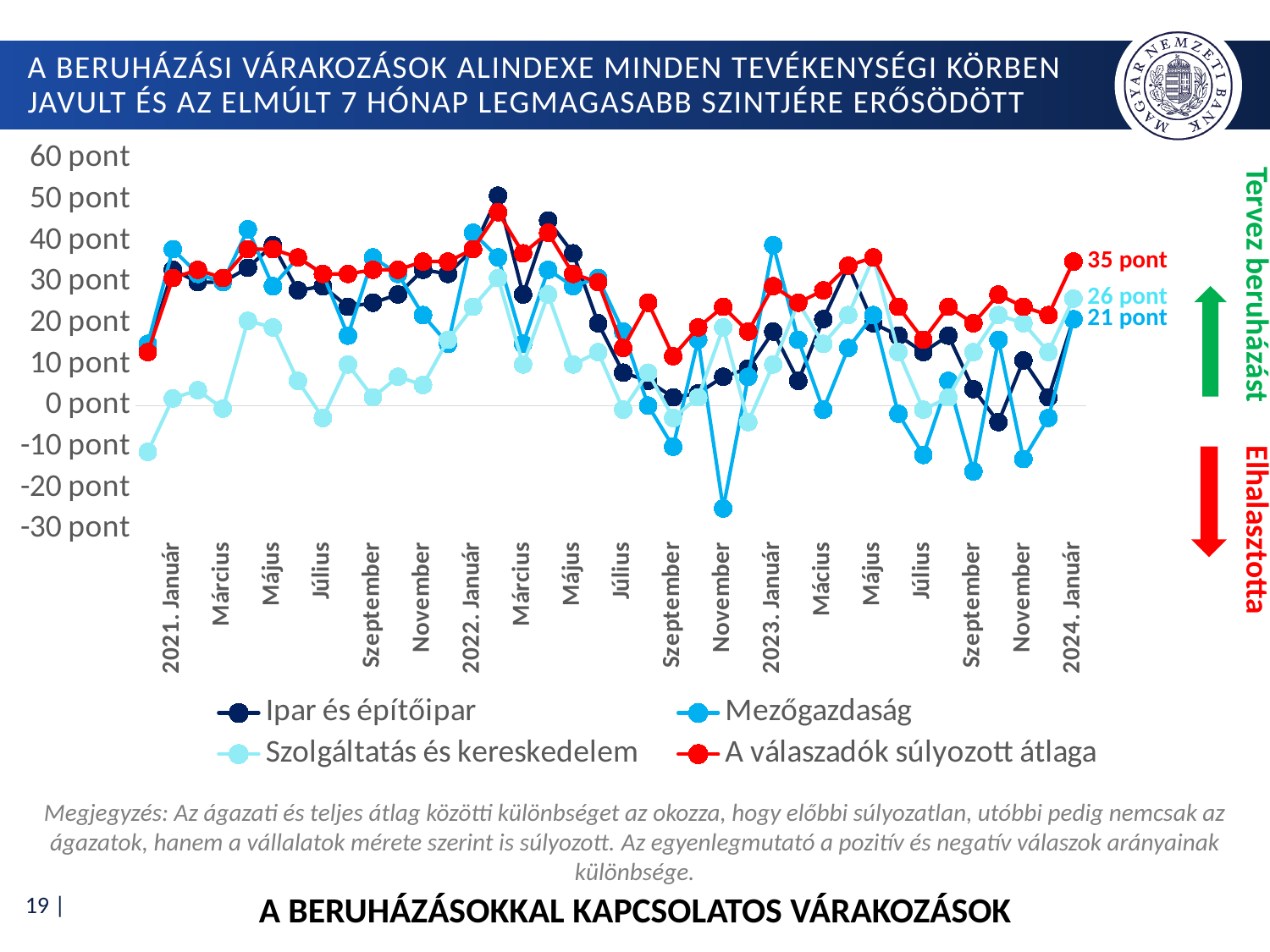
What is the difference between 'A válaszadók súlyozott átlaga' and 'Szolgáltatás és kereskedelem' in 2024. Január? 9 pont What is the title printed below the chart? A BERUHÁZÁSOKKAL KAPCSOLATOS VÁRAKOZÁSOK What is the value of 'Mezőgazdaság' in 2024. Január? 21 pont What is the value of 'A válaszadók súlyozott átlaga' in 2024. Január? 35 pont Is the value for 'Mezőgazdaság' in November 2022 greater or less than -20 pont? less In 2024. Január, which is larger: 'A válaszadók súlyozott átlaga' or 'Szolgáltatás és kereskedelem'? A válaszadók súlyozott átlaga What kind of chart is shown on the slide? line chart What is the difference between 'A válaszadók súlyozott átlaga' and 'Mezőgazdaság' in 2024. Január? 14 pont How many series does the legend list? 4 What is the value of 'Szolgáltatás és kereskedelem' in 2024. Január? 26 pont